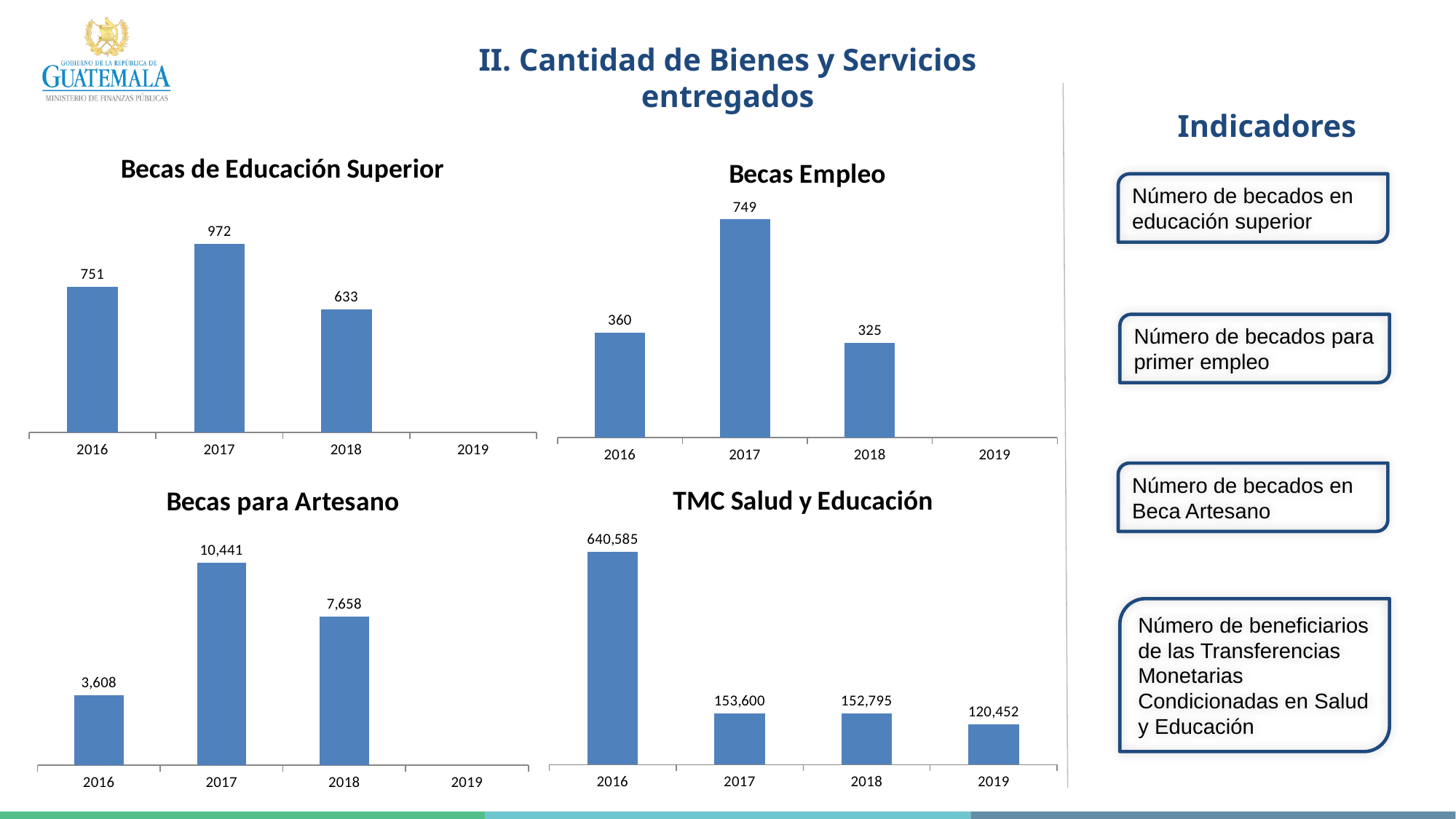
What kind of chart is the 'Becas Empleo' chart? bar chart In the 'Becas para Artesano' chart, what is the value for 2018? 7,658 In the 'Becas de Educación Superior' chart, what is the value for 2017? 972 In the 'Becas para Artesano' chart, which is larger, the value for 2016 or the value for 2018? 2018 How many year categories are shown on the x axis of the 'TMC Salud y Educación' chart? 4 In the 'Becas Empleo' chart, what is the value for 2016? 360 In the 'TMC Salud y Educación' chart, what is the value for 2016? 640,585 In the 'TMC Salud y Educación' chart, what is the value for 2019? 120,452 In the 'Becas de Educación Superior' chart, which year has the lowest value among the years with bars? 2018 In the 'TMC Salud y Educación' chart, do the values rise or fall from 2016 to 2019? fall In the 'Becas Empleo' chart, which year has the highest value? 2017 In the 'Becas Empleo' chart, what is the difference between the 2017 and 2018 values? 424